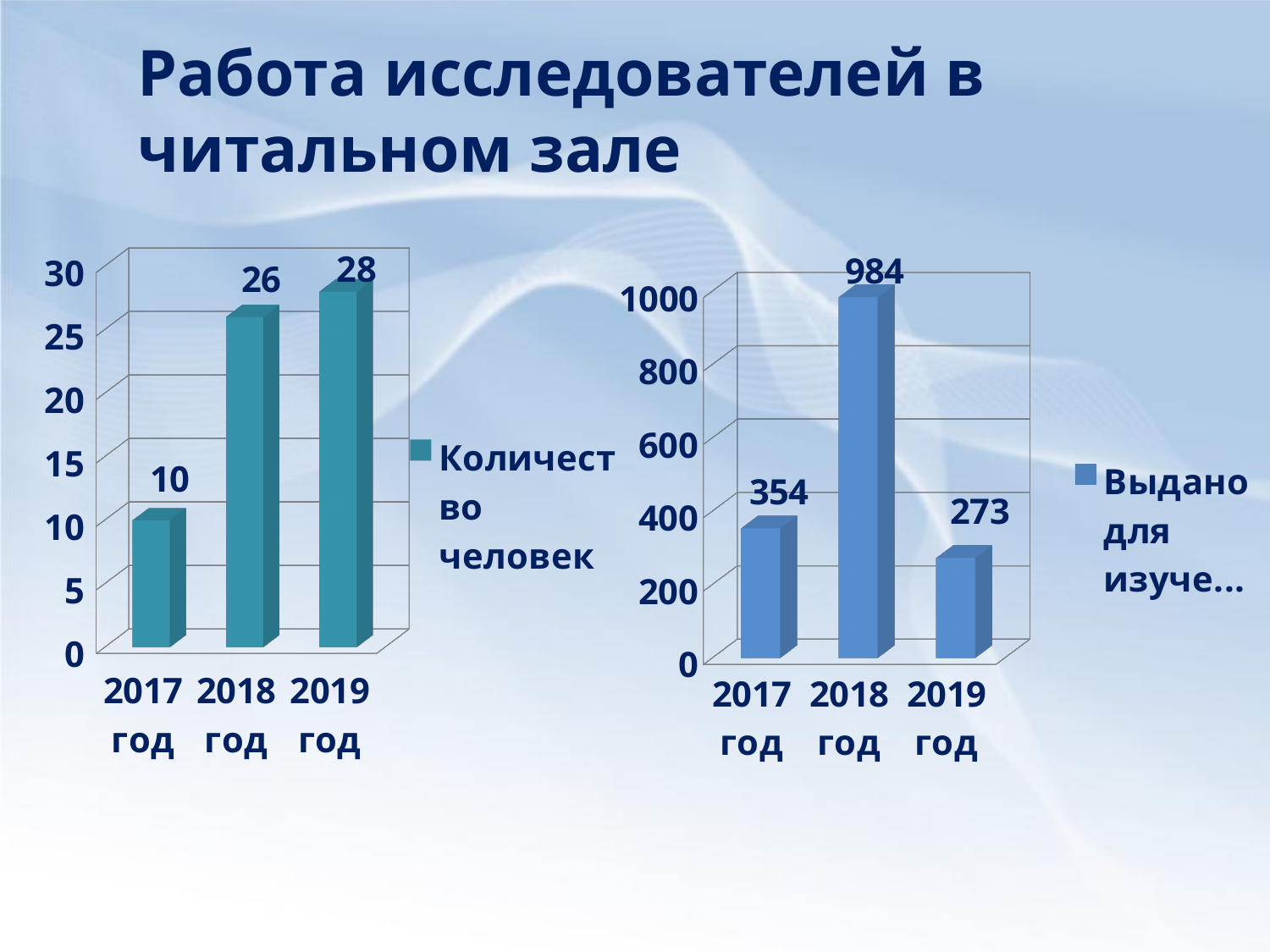
In the left chart (Количество человек), what is the difference between the values for 2019 год and 2017 год? 18 How many categories does the right chart (Выдано для изуче...) show? 3 In the left chart (Количество человек), which year has the highest value? 2019 год In the right chart (Выдано для изуче...), which year has the lowest value? 2019 год In the left chart (Количество человек), do the values rise or fall from 2017 год to 2019 год? rise In the right chart (Выдано для изуче...), which is larger, the value for 2017 год or 2019 год? 2017 год In the right chart (Выдано для изуче...), what is the value for 2019 год? 273 In the right chart (Выдано для изуче...), what is the value for 2018 год? 984 In the left chart (Количество человек), what is the value for 2018 год? 26 What kind of chart is the left chart (Количество человек)? bar chart In the left chart (Количество человек), what is the value for 2017 год? 10 In the right chart (Выдано для изуче...), what is the difference between the values for 2018 год and 2017 год? 630